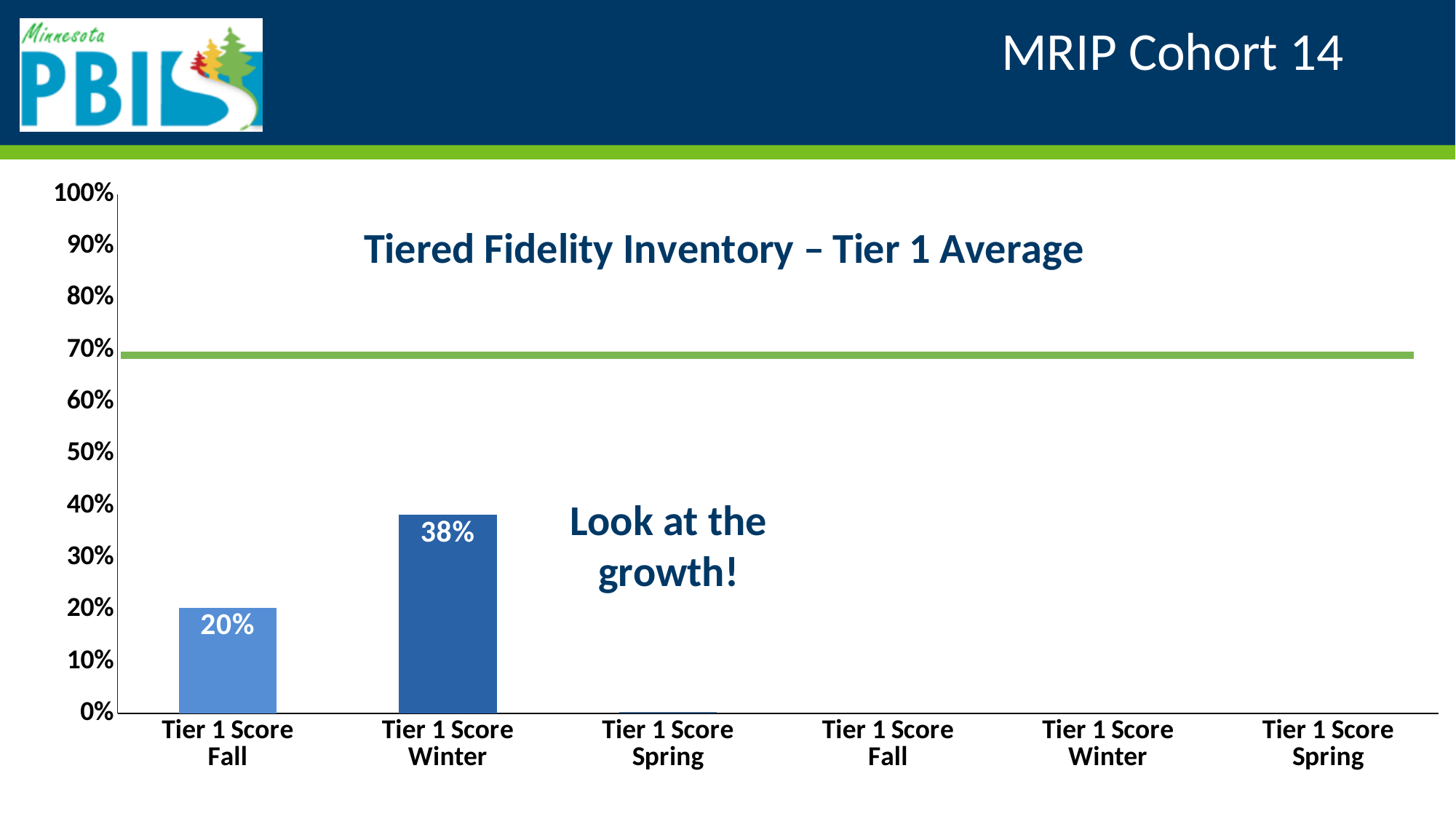
How many category labels are shown on the x axis? 6 What kind of chart is shown on the slide? bar chart Do the values rise or fall from Tier 1 Score Fall to Tier 1 Score Winter? rise Which is larger, the Tier 1 Score Fall value or the Tier 1 Score Winter value? Tier 1 Score Winter How many bars have a plotted value on the chart? 2 What is the difference between the Tier 1 Score Winter value and the Tier 1 Score Fall value? 18% Which category has the highest plotted value? Tier 1 Score Winter Is the value for Tier 1 Score Winter greater or less than 30%? greater What is the value for the first Tier 1 Score Winter bar? 38% Is the value for the first Tier 1 Score Fall greater or less than 30%? less What is the title of the chart? Tiered Fidelity Inventory – Tier 1 Average What is the value for the first Tier 1 Score Fall bar? 20%